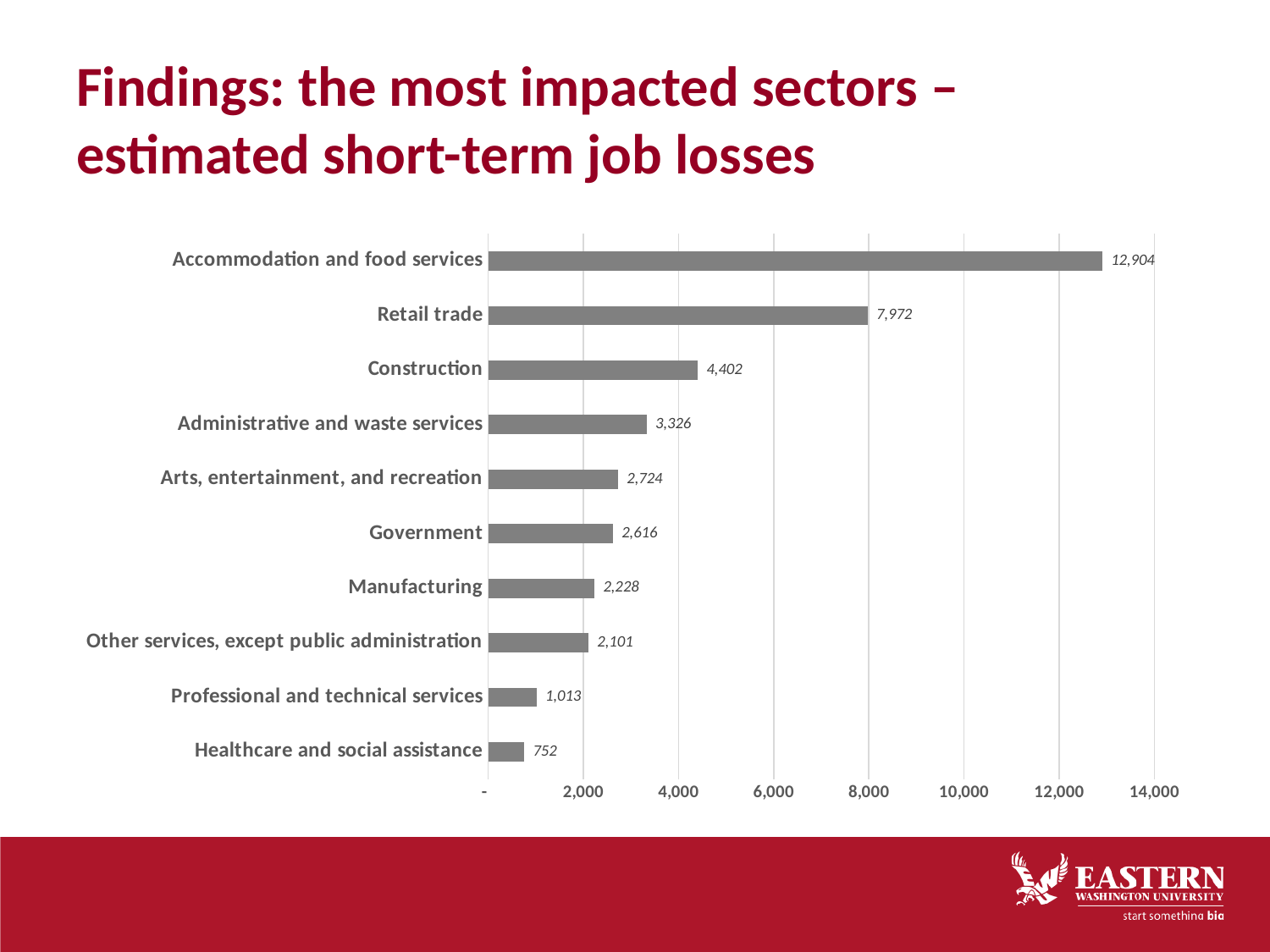
What is the difference between the values for Accommodation and food services and Retail trade? 4,932 What is the value shown for Healthcare and social assistance? 752 What is the value shown for Construction? 4,402 What kind of chart is shown on the slide? Bar chart What is the maximum value shown on the horizontal axis? 14,000 Is the value for Retail trade greater or less than 8,000? less Which has a larger value, Government or Arts, entertainment, and recreation? Arts, entertainment, and recreation Which sector has the lowest estimated short-term job losses? Healthcare and social assistance How many sectors are shown in the chart? 10 Which sector has the highest estimated short-term job losses? Accommodation and food services What is the estimated short-term job loss for Accommodation and food services? 12,904 What is the difference between the values for Manufacturing and Other services, except public administration? 127